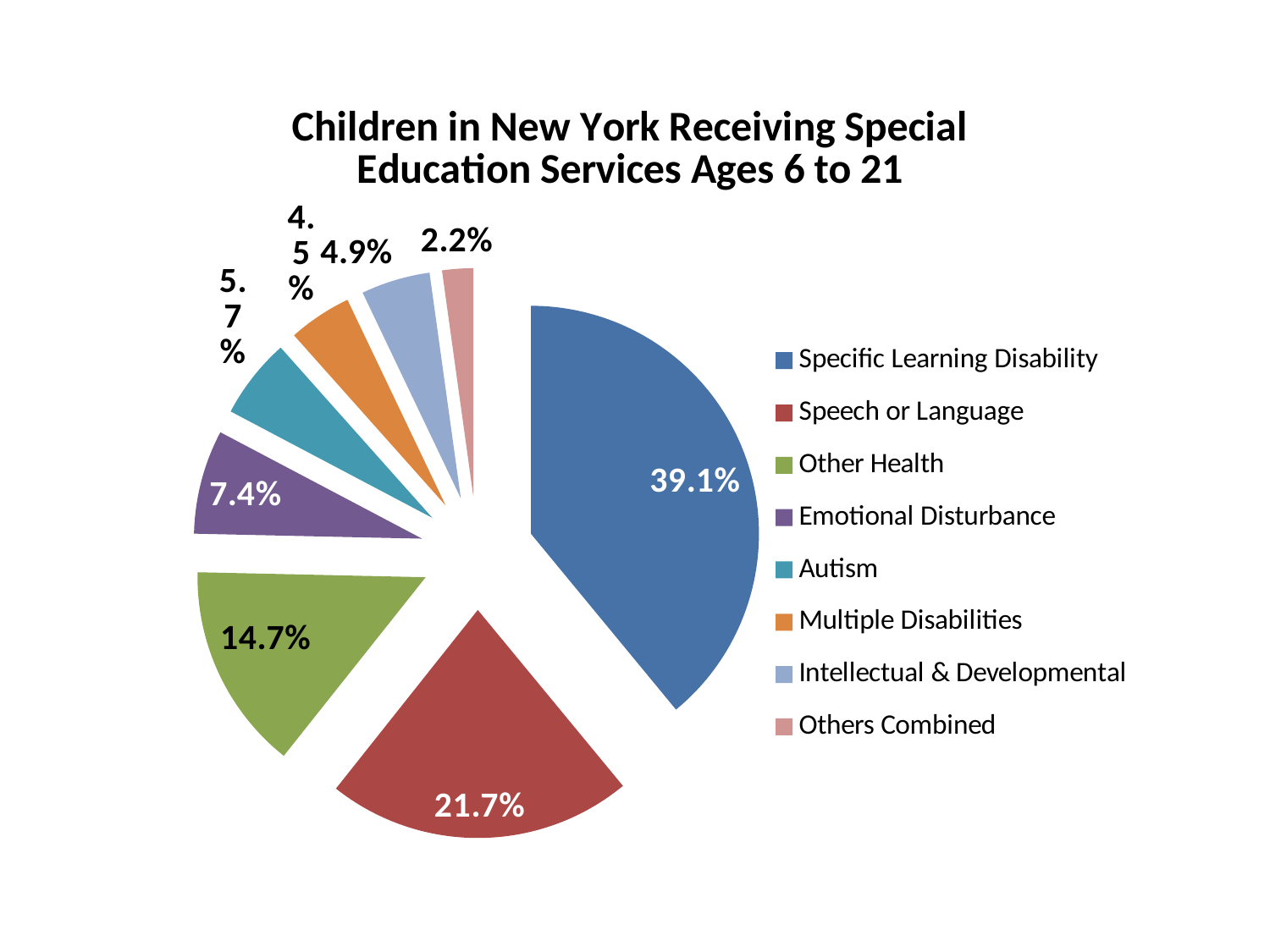
How many categories does the legend list? 8 What percentage of the pie is Speech or Language? 21.7% What is the difference in percentage points between Specific Learning Disability and Speech or Language? 17.4 What percentage of the pie is Specific Learning Disability? 39.1% Which category has the smallest slice of the pie? Others Combined What kind of chart is shown on the slide? pie chart Which is larger, the slice for Speech or Language or the slice for Other Health? Speech or Language What percentage of the pie is Emotional Disturbance? 7.4% What is the title of the chart? Children in New York Receiving Special Education Services Ages 6 to 21 What percentage of the pie is Others Combined? 2.2% Which category has the largest slice of the pie? Specific Learning Disability What percentage of the pie is Other Health? 14.7%